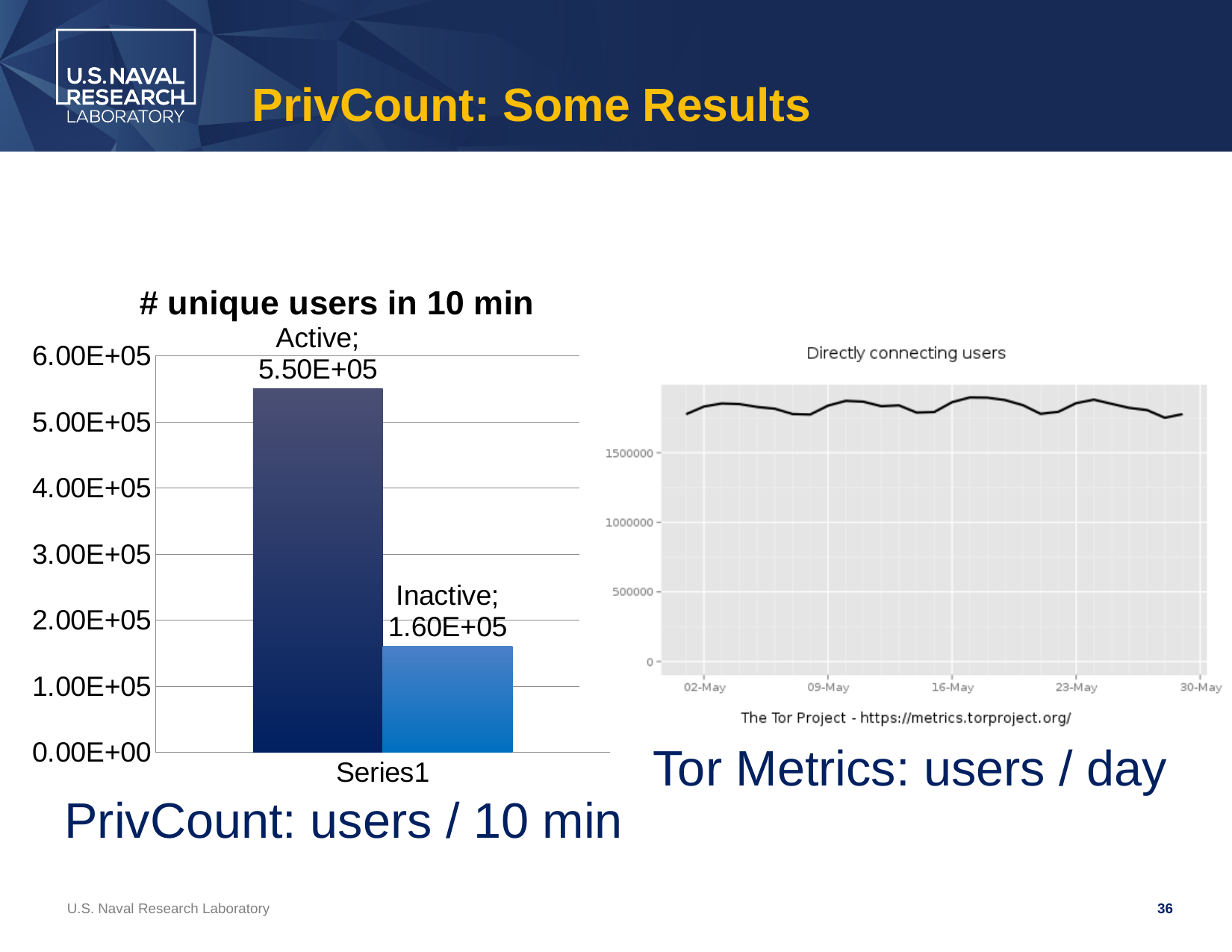
What kind of chart is the '# unique users in 10 min' chart? bar chart In the '# unique users in 10 min' chart, which bar is the highest? Active In the '# unique users in 10 min' chart, which bar is the lowest? Inactive What is the x-axis label shown under the bars in the '# unique users in 10 min' chart? Series1 In the 'Directly connecting users' chart, is the value on 16-May greater or less than 1500000? greater In the '# unique users in 10 min' chart, what is the value for Inactive? 1.60E+05 What kind of chart is the 'Directly connecting users' chart on the right? line chart In the '# unique users in 10 min' chart, what is the value for Active? 5.50E+05 How many bars are plotted in the '# unique users in 10 min' chart? 2 In the '# unique users in 10 min' chart, is the Active value greater or less than 5.00E+05? greater In the '# unique users in 10 min' chart, is the Inactive value greater or less than 2.00E+05? less In the '# unique users in 10 min' chart, what is the difference between the Active and Inactive values? 3.90E+05